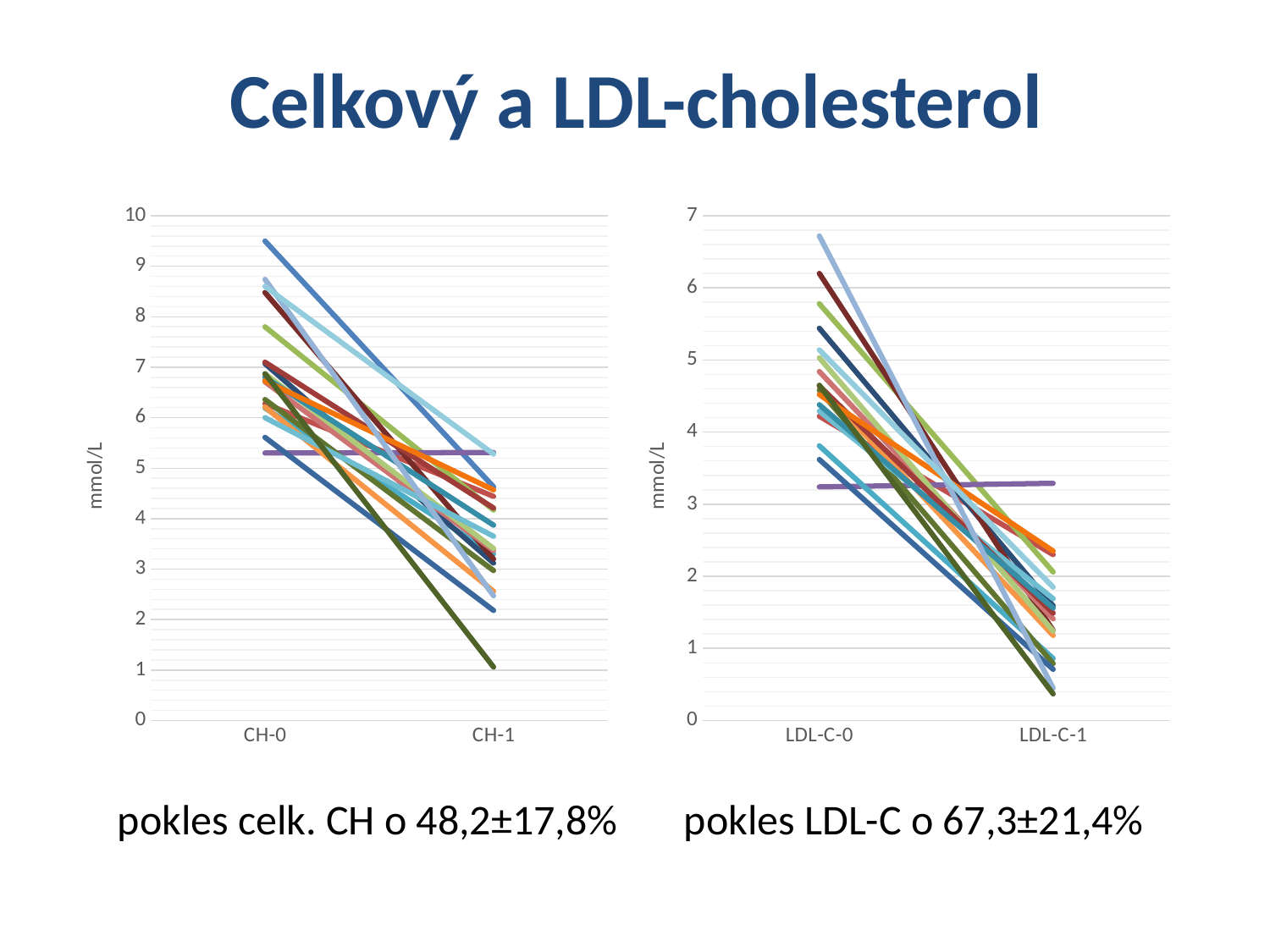
In the right chart, do most lines rise or fall from LDL-C-0 to LDL-C-1? fall In the right chart, is the highest value at LDL-C-0 greater or less than 6? greater What kind of chart is the right chart (LDL-C-0 to LDL-C-1)? line chart In the right chart, is the lowest value at LDL-C-1 greater or less than 1? less In the right chart, how many categories are shown on the x axis? 2 In the left chart, is the lowest value at CH-1 greater or less than 2? less What kind of chart is the left chart (CH-0 to CH-1)? line chart What is the y-axis label on the left chart? mmol/L In the left chart, do most lines rise or fall from CH-0 to CH-1? fall What is the maximum value shown on the y axis of the right chart? 7 In the left chart, how many categories are shown on the x axis? 2